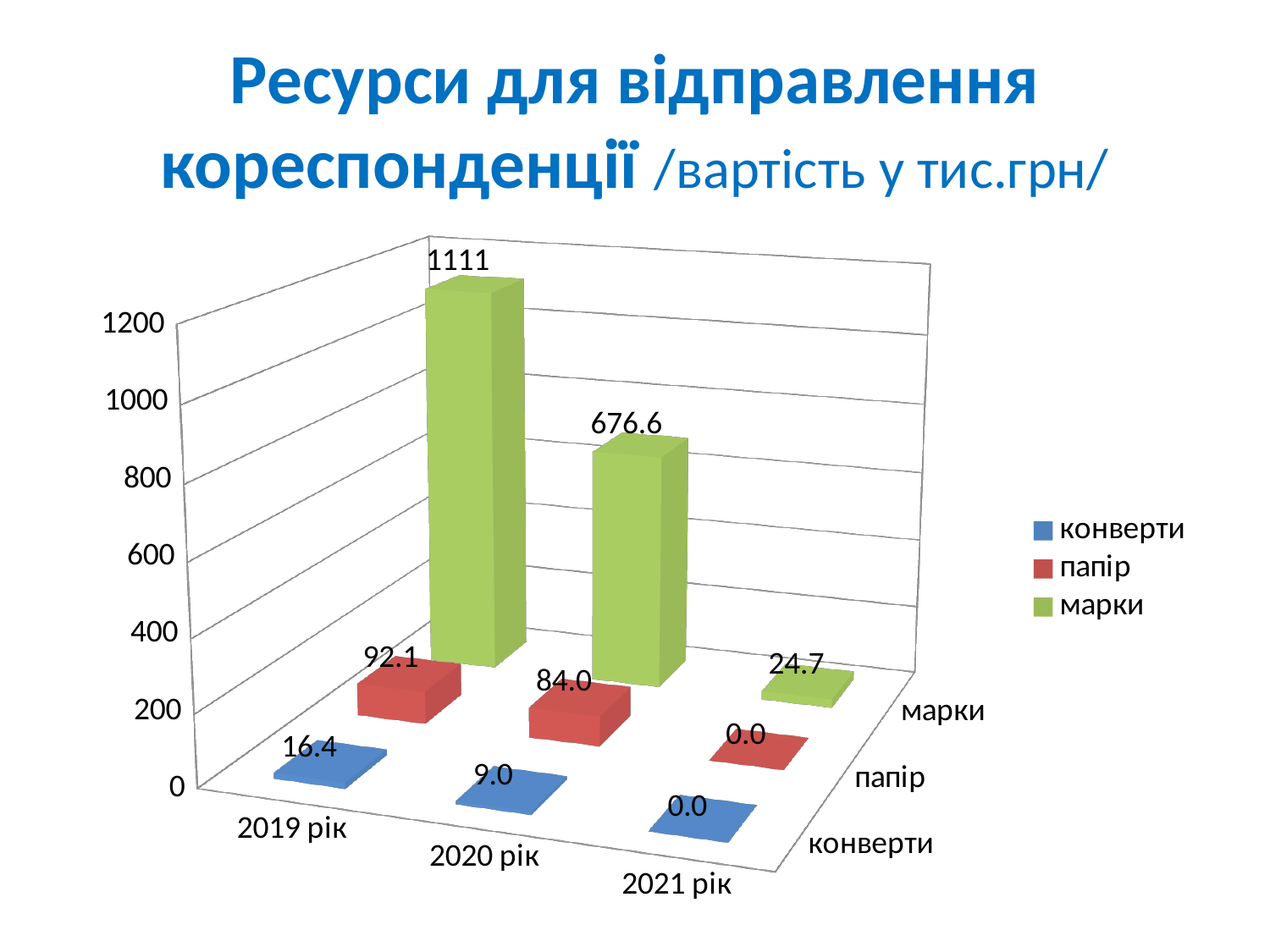
Which is larger: папір in 2019 рік or папір in 2020 рік? папір in 2019 рік What is the value for папір in 2020 рік? 84.0 What is the value for конверти in 2019 рік? 16.4 Do the values for марки rise or fall from 2019 рік to 2021 рік? fall What kind of chart is shown on the slide? bar chart What is the value for марки in 2019 рік? 1111 How many years are shown on the x axis? 3 What is the value for марки in 2021 рік? 24.7 What is the difference between the марки values for 2019 рік and 2020 рік? 434.4 How many series does the legend list? 3 Which year has the highest value for марки? 2019 рік Which year has the lowest value for конверти? 2021 рік